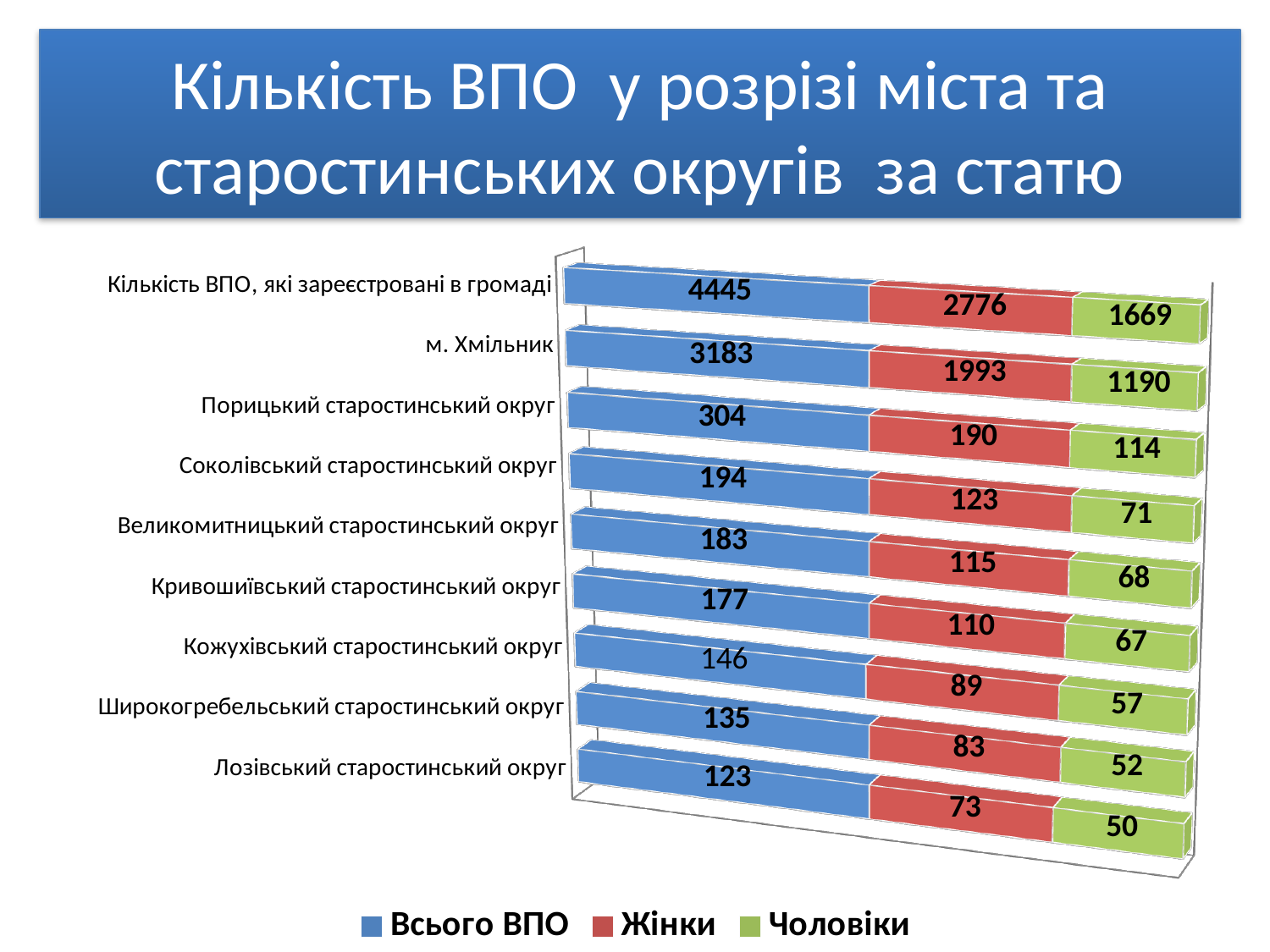
What kind of chart is shown on the slide? Stacked bar chart Which category has the lowest value of Всього ВПО? Лозівський старостинський округ What is the value of Жінки for Кількість ВПО, які зареєстровані в громаді? 2776 Which category has the highest value of Чоловіки? Кількість ВПО, які зареєстровані в громаді What is the difference between the Жінки and Чоловіки values for м. Хмільник? 803 How many categories are shown on the chart? 9 How many series does the legend list? 3 Which colour represents the Жінки series? Red What is the value of Всього ВПО for м. Хмільник? 3183 What is the value of Жінки for Порицький старостинський округ? 190 Which is larger: the Всього ВПО value for Кривошиївський старостинський округ or for Кожухівський старостинський округ? Кривошиївський старостинський округ What is the value of Чоловіки for Соколівський старостинський округ? 71